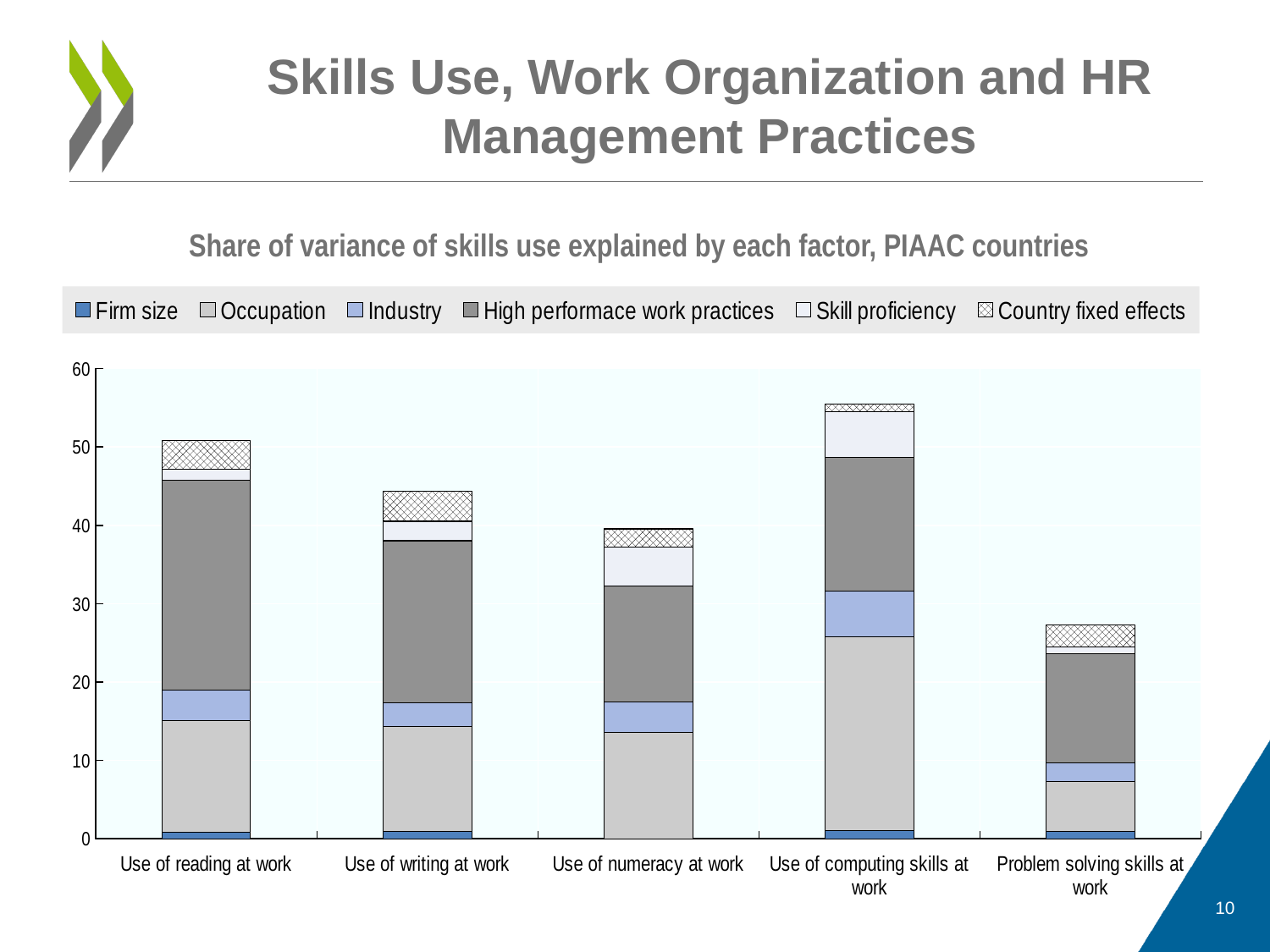
What is the subtitle of the chart? Share of variance of skills use explained by each factor, PIAAC countries How many series does the chart's legend list? 6 Which category has the tallest stacked bar? Use of computing skills at work Which legend entry is shown with a cross-hatched pattern? Country fixed effects How many categories are shown along the x axis of the chart? 5 Which has the taller stacked bar: Use of reading at work or Use of writing at work? Use of reading at work Is the total stacked bar for Use of numeracy at work greater or less than 30? greater Is the total stacked bar for Problem solving skills at work greater or less than 30? less Which category has the shortest stacked bar? Problem solving skills at work What kind of chart is shown on the slide? stacked bar chart Is the total stacked bar for Use of writing at work greater or less than 40? greater